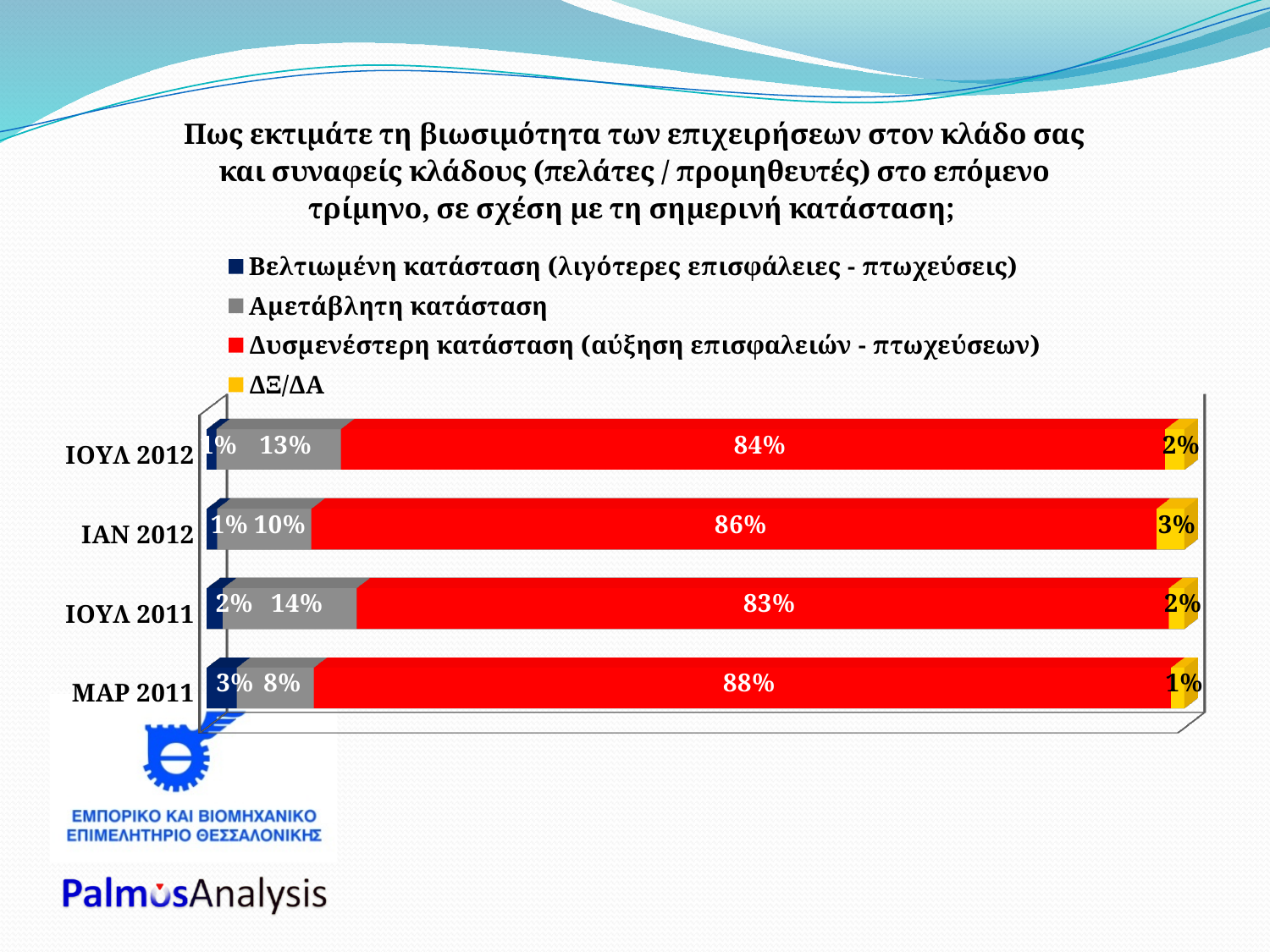
How many series does the legend list? 4 What type of chart is shown on the slide? Stacked bar chart Which colour represents the ΔΞ/ΔΑ series in the chart? Yellow What is the difference between the Δυσμενέστερη κατάσταση values for ΙΑΝ 2012 and ΙΟΥΛ 2011? 3% Which is larger: the Αμετάβλητη κατάσταση value for ΙΟΥΛ 2012 or for ΙΟΥΛ 2011? ΙΟΥΛ 2011 How many categories (survey periods) are shown on the chart? 4 What is the value of Αμετάβλητη κατάσταση for ΙΑΝ 2012? 10% Which period has the highest value for Δυσμενέστερη κατάσταση? ΜΑΡ 2011 Which period has the lowest value for Αμετάβλητη κατάσταση? ΜΑΡ 2011 What is the value of Δυσμενέστερη κατάσταση for ΙΟΥΛ 2012? 84% What is the value of ΔΞ/ΔΑ for ΙΑΝ 2012? 3% What is the value of Βελτιωμένη κατάσταση for ΜΑΡ 2011? 3%